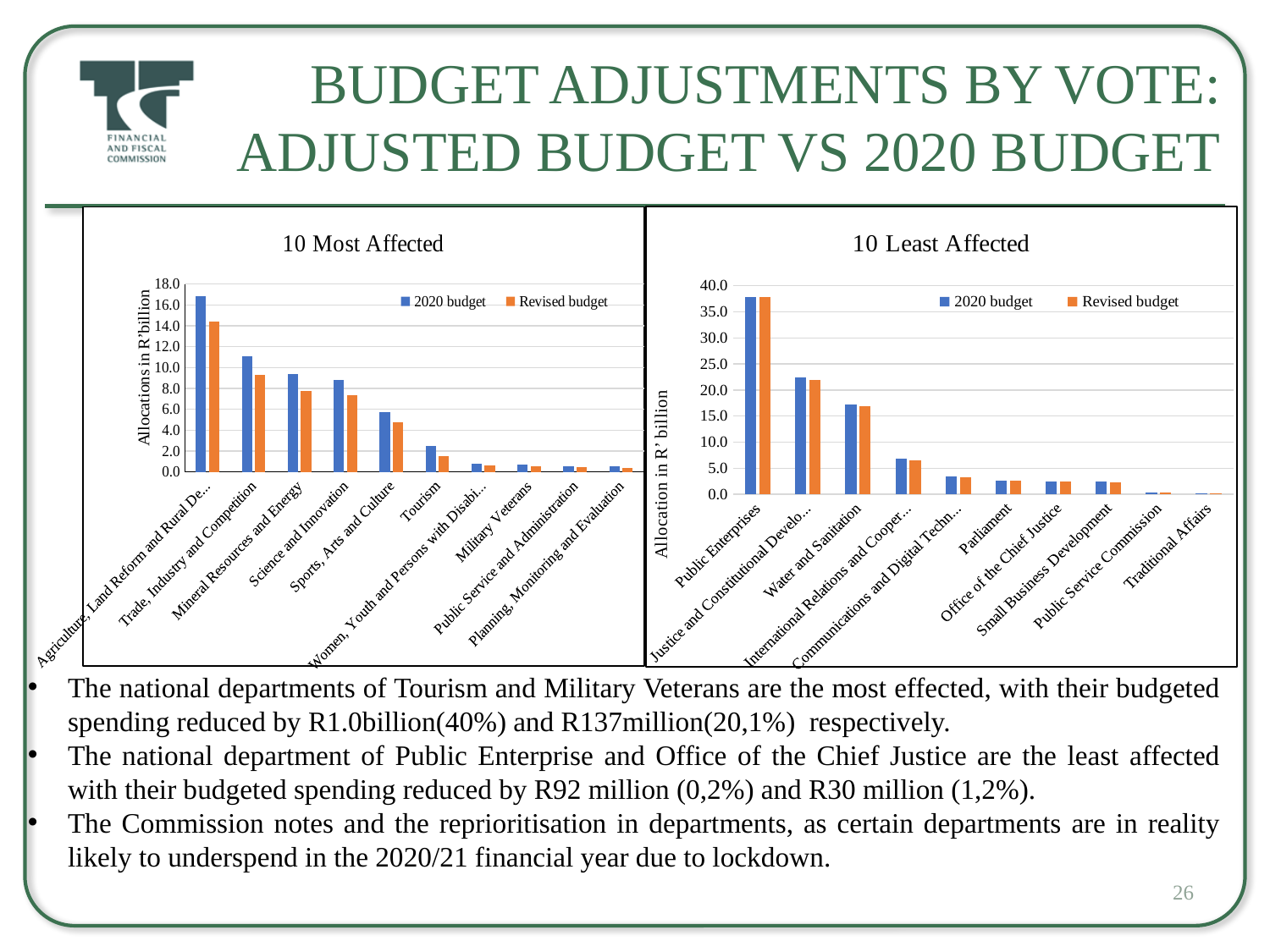
How many series does the legend of the "10 Least Affected" chart list? 2 In the "10 Most Affected" chart, which category has the highest 2020 budget? Agriculture, Land Reform and Rural De... In the "10 Most Affected" chart, which is larger for Tourism: the 2020 budget or the Revised budget? 2020 budget In the "10 Most Affected" chart, is the Revised budget for Tourism greater or less than 2.0? less In the "10 Least Affected" chart, do the 2020 budget values rise or fall from left to right along the x axis? fall What kind of chart is the "10 Most Affected" chart? bar chart In the "10 Least Affected" chart, which category has the highest 2020 budget? Public Enterprises In the "10 Most Affected" chart, is the 2020 budget for Tourism greater or less than 2.0? greater In the "10 Least Affected" chart, is the 2020 budget for Public Enterprises greater or less than 35.0? greater In the "10 Least Affected" chart, which category has the lowest Revised budget? Traditional Affairs How many categories are shown on the x axis of the "10 Most Affected" chart? 10